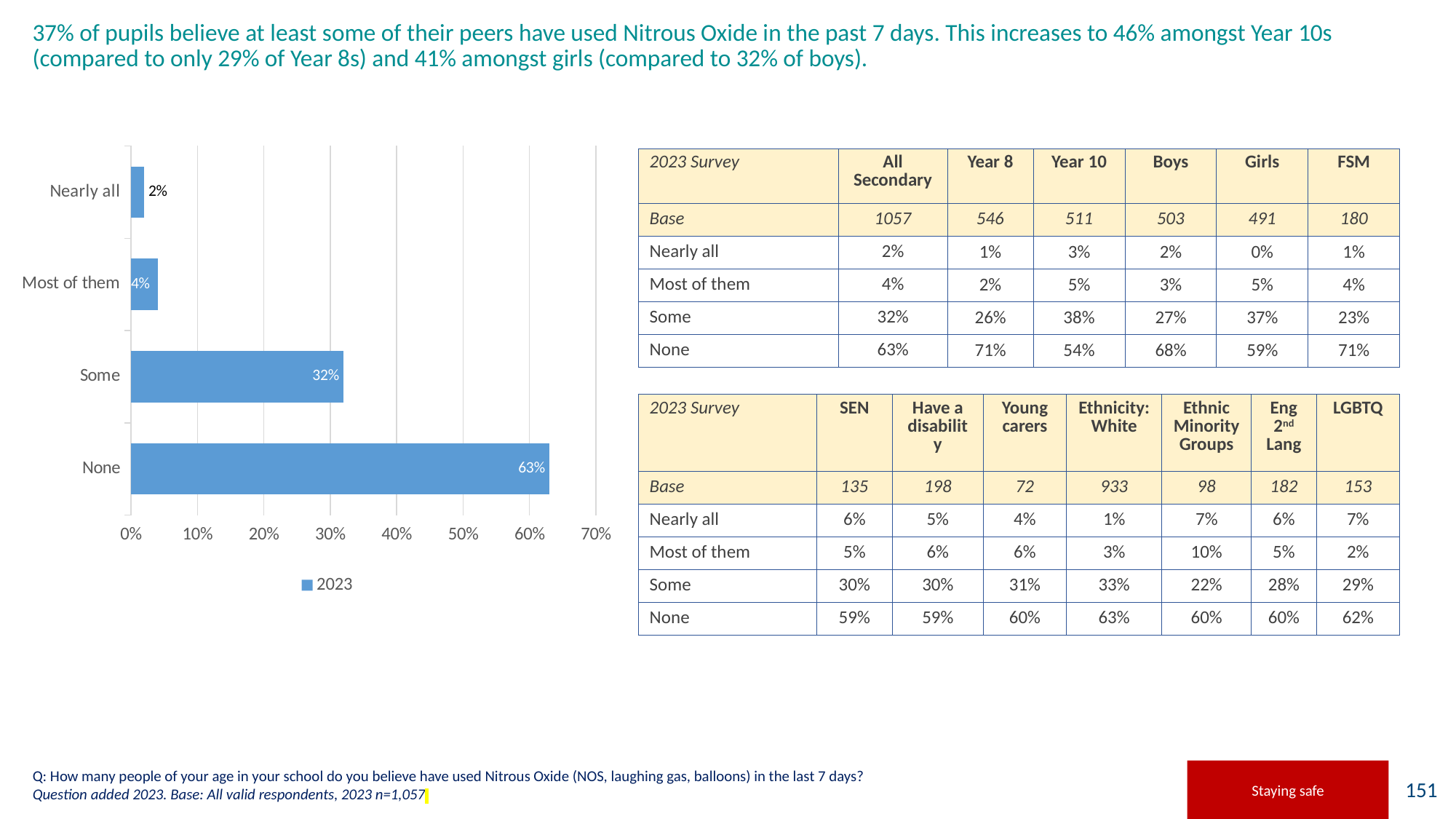
How many categories are shown in the bar chart? 4 Which category has the lowest value in the bar chart? Nearly all What is the value for "Some" in the bar chart? 32% Which is larger in the bar chart, the value for "Some" or the value for "Most of them"? Some What kind of chart is shown on the slide? Bar chart What is the difference between the values for "None" and "Some" in the bar chart? 31% What is the value for "Most of them" in the bar chart? 4% What is the value for "None" in the bar chart? 63% What is the value for "Nearly all" in the bar chart? 2% How many series does the legend of the bar chart list? 1 Which category has the highest value in the bar chart? None Is the value for "None" in the bar chart greater or less than 50%? greater